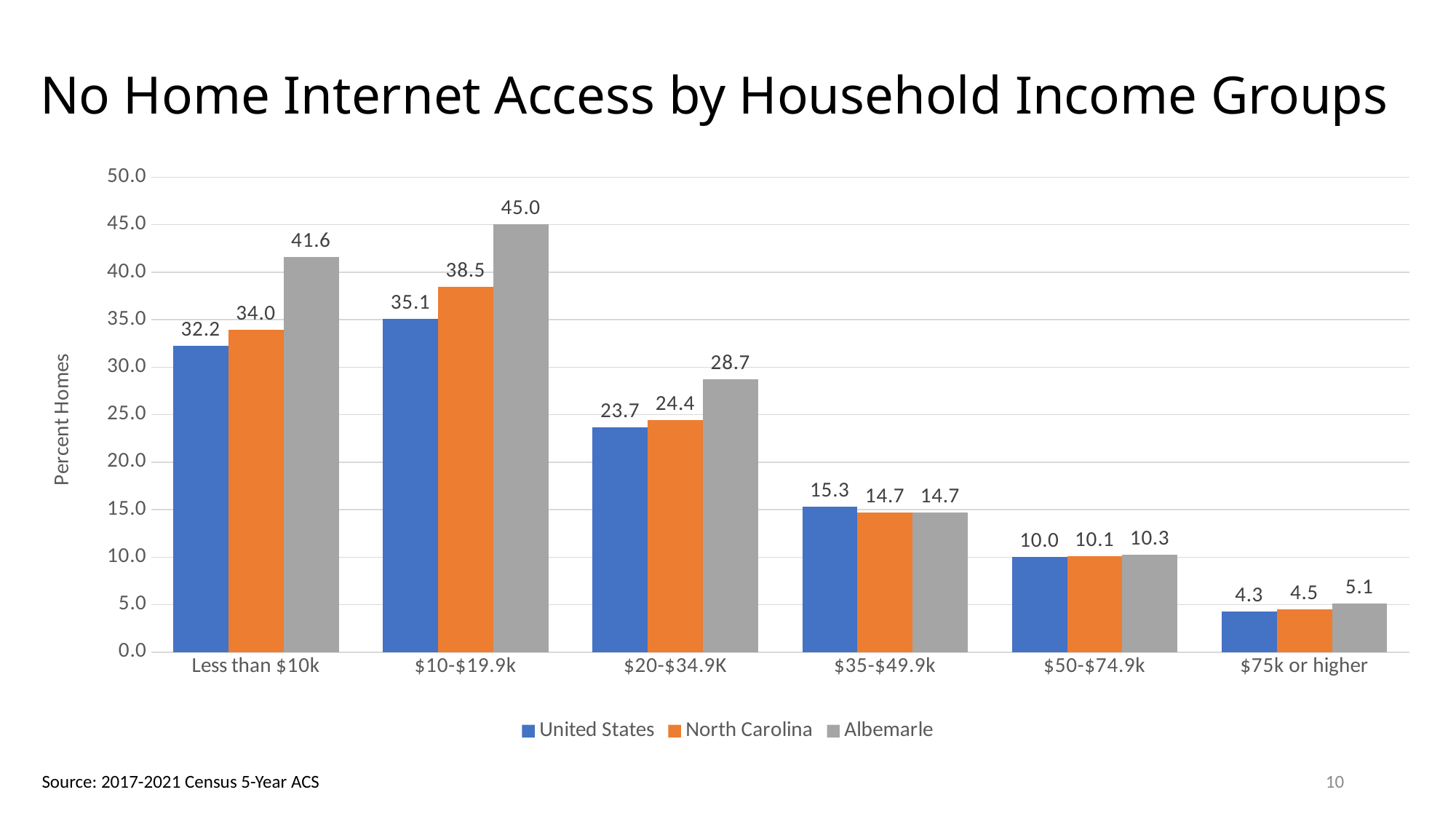
Which income group has the highest value for Albemarle? $10-$19.9k Which income group has the lowest value for the United States? $75k or higher What is the value for North Carolina in the $20-$34.9K income group? 24.4 Which is larger in the $35-$49.9k income group: the United States value or the North Carolina value? United States What is the value for the United States in the Less than $10k income group? 32.2 What is the label of the y axis? Percent Homes What kind of chart is shown on the slide? Bar chart What is the difference between the Albemarle and United States values in the Less than $10k income group? 9.4 Do the Albemarle values rise or fall from the $10-$19.9k group to the $75k or higher group? Fall How many income groups are shown on the x axis? 6 What is the value for Albemarle in the $10-$19.9k income group? 45.0 How many series does the legend list? 3